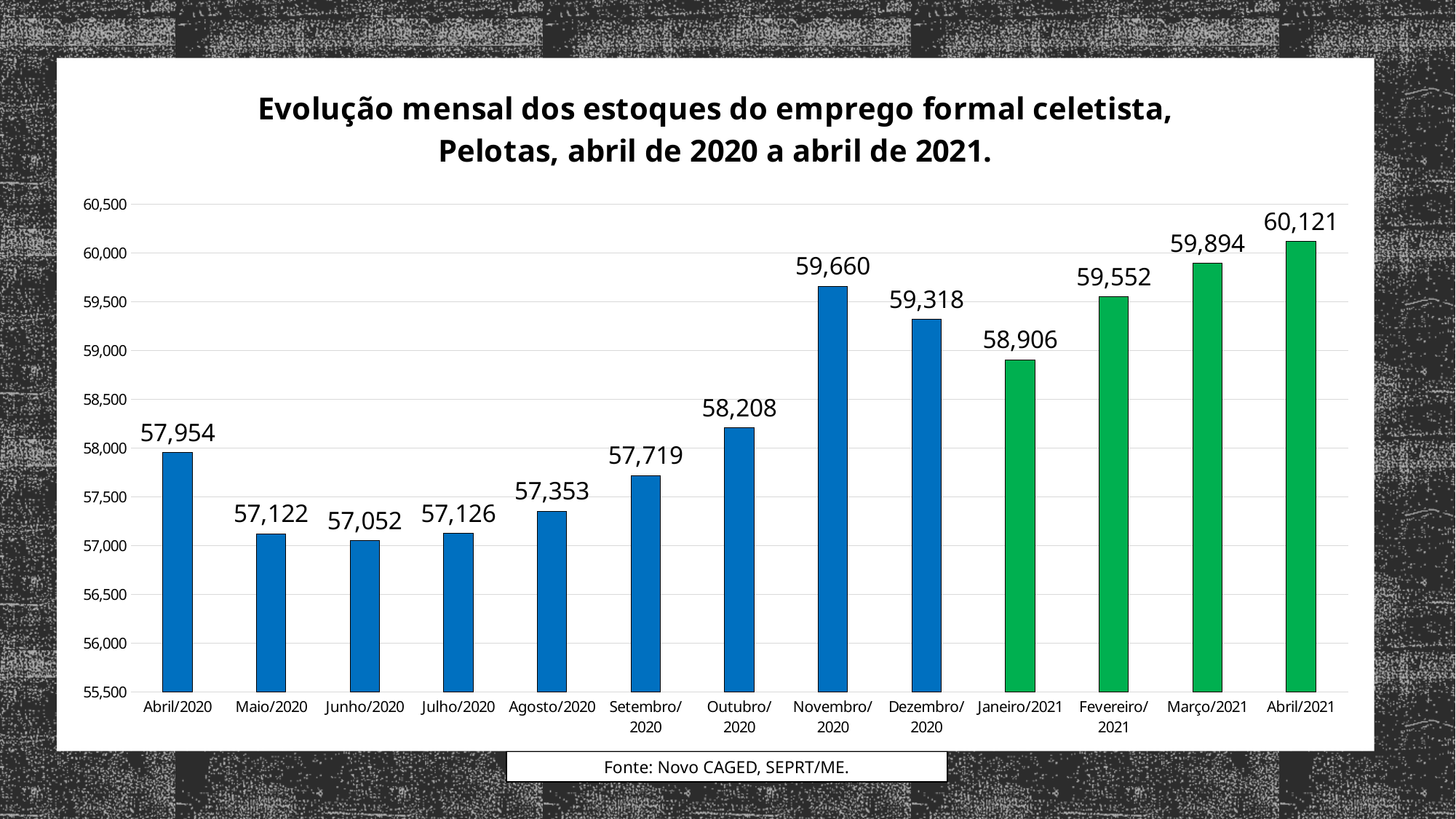
What is the difference between the values for Abril/2021 and Abril/2020? 2,167 What kind of chart is shown on the slide? bar chart Is the value for Outubro/2020 greater or less than 58,000? greater What is the source cited below the chart? Novo CAGED, SEPRT/ME. Which month has the highest value? Abril/2021 What is the value for Janeiro/2021? 58,906 Which month has the lowest value? Junho/2020 How many months are shown on the chart? 13 Which is larger, the value for Dezembro/2020 or the value for Fevereiro/2021? Fevereiro/2021 What is the value for Abril/2020? 57,954 What is the value for Novembro/2020? 59,660 What is the difference between the values for Novembro/2020 and Dezembro/2020? 342